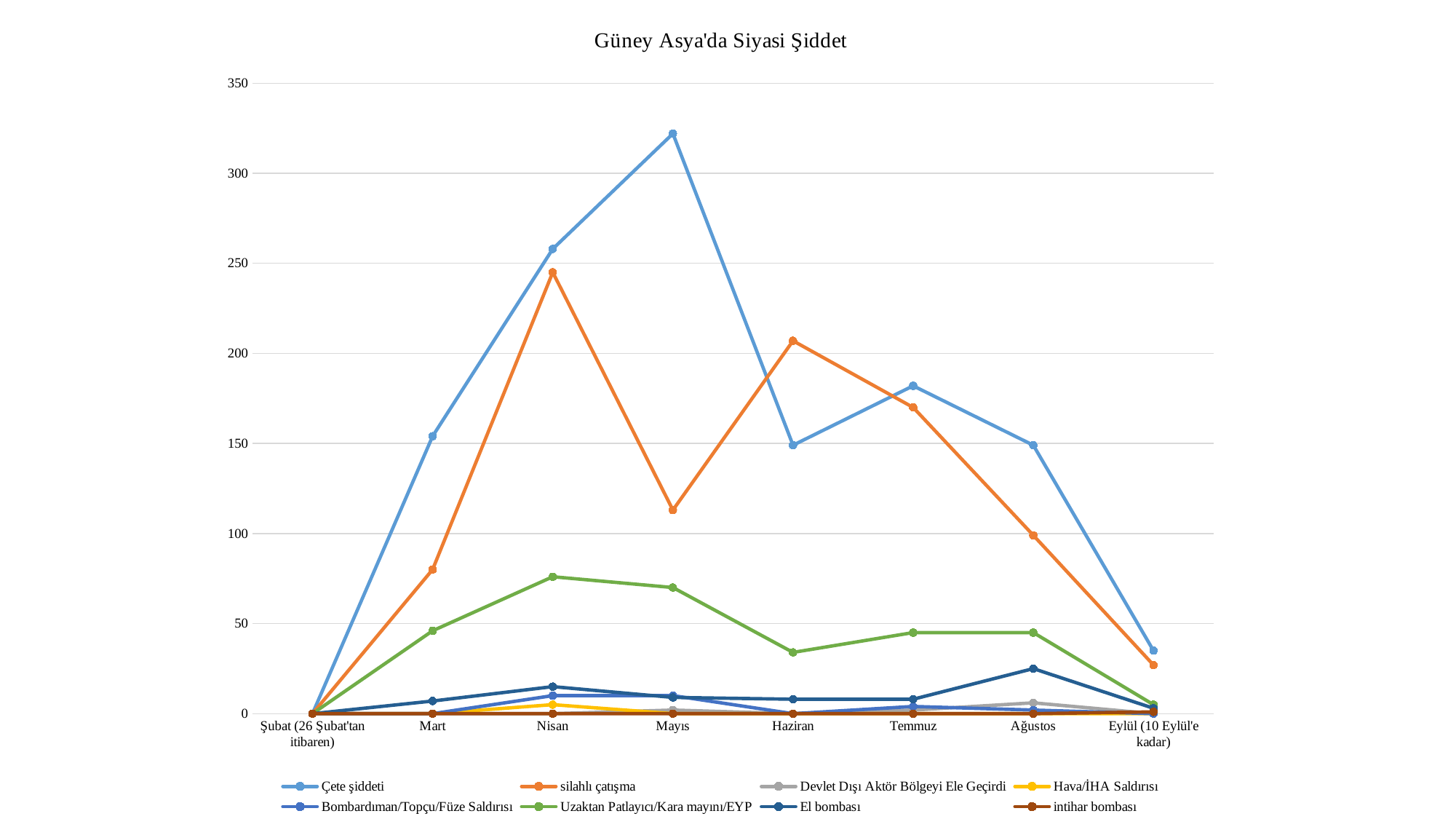
How many categories are shown along the x axis? 8 Does the Çete şiddeti series rise or fall from Temmuz to Eylül (10 Eylül'e kadar)? fall Is the value for Uzaktan Patlayıcı/Kara mayını/EYP in Nisan greater or less than 100? less In which month does the Çete şiddeti series reach its highest value? Mayıs In which month does the silahlı çatışma series reach its highest value? Nisan What is the title of the chart? Güney Asya'da Siyasi Şiddet Which series has the higher value in Nisan, Çete şiddeti or Uzaktan Patlayıcı/Kara mayını/EYP? Çete şiddeti Is the value for silahlı çatışma in Mayıs greater or less than 150? less How many series does the legend list? 8 What kind of chart is shown on the slide? line chart Is the value for Çete şiddeti in Mayıs greater or less than 300? greater Which series has the higher value in Haziran, Çete şiddeti or silahlı çatışma? silahlı çatışma